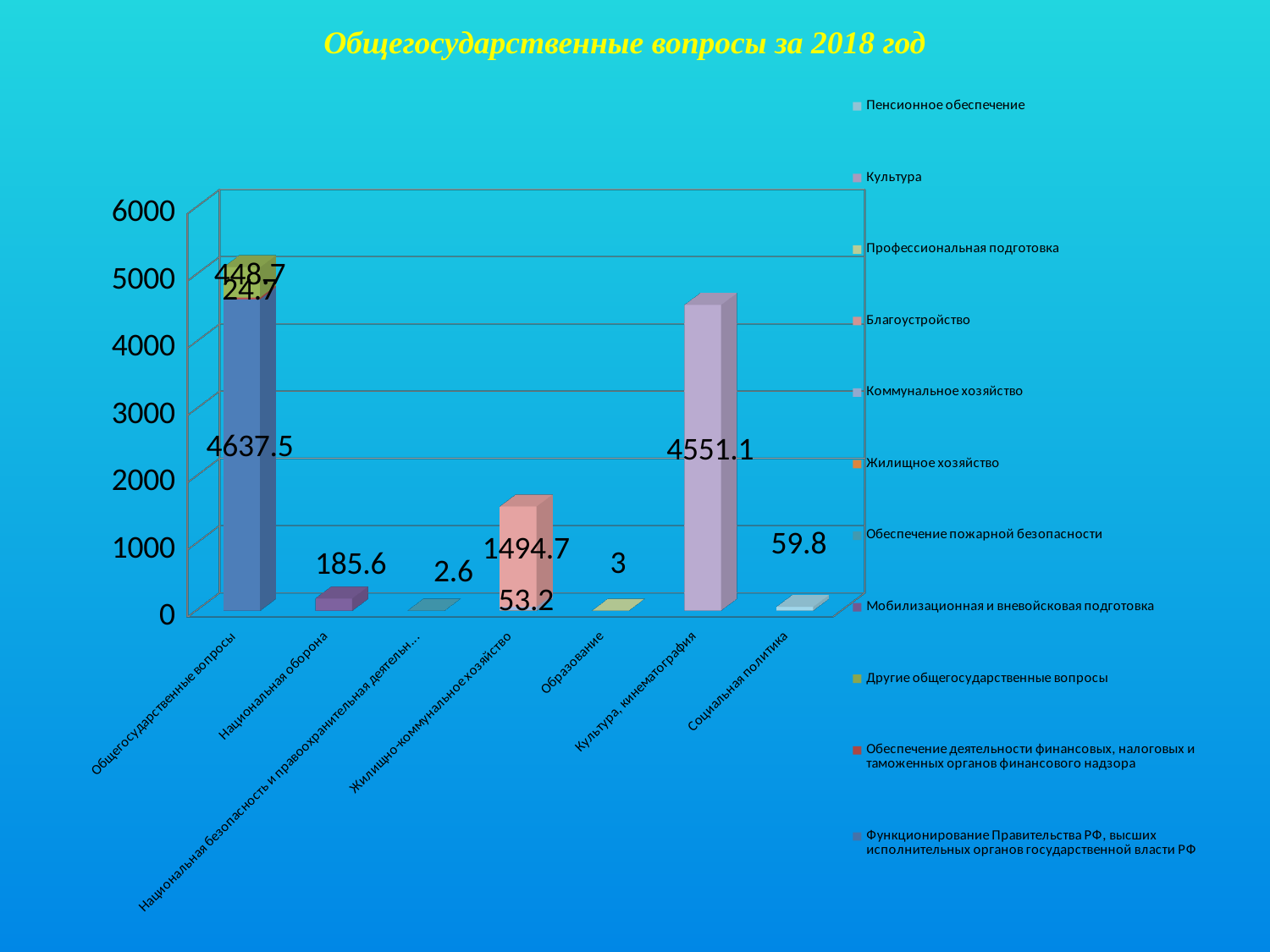
What is the title of the chart? Общегосударственные вопросы за 2018 год How many series does the legend list? 11 Is the value for Культура, кинематография greater or less than 4000? greater What is the largest value labelled on the Жилищно-коммунальное хозяйство bar? 1494.7 How many categories are shown along the x axis? 7 What is the value labelled on the bar for Социальная политика? 59.8 What kind of chart is shown on the slide? bar chart What is the difference between the 4637.5 segment of Общегосударственные вопросы and the value for Культура, кинематография? 86.4 Which is larger, the value for Национальная оборона or the value for Социальная политика? Национальная оборона Which category has the tallest bar? Общегосударственные вопросы What is the value labelled on the bar for Национальная оборона? 185.6 What is the value labelled on the bar for Культура, кинематография? 4551.1